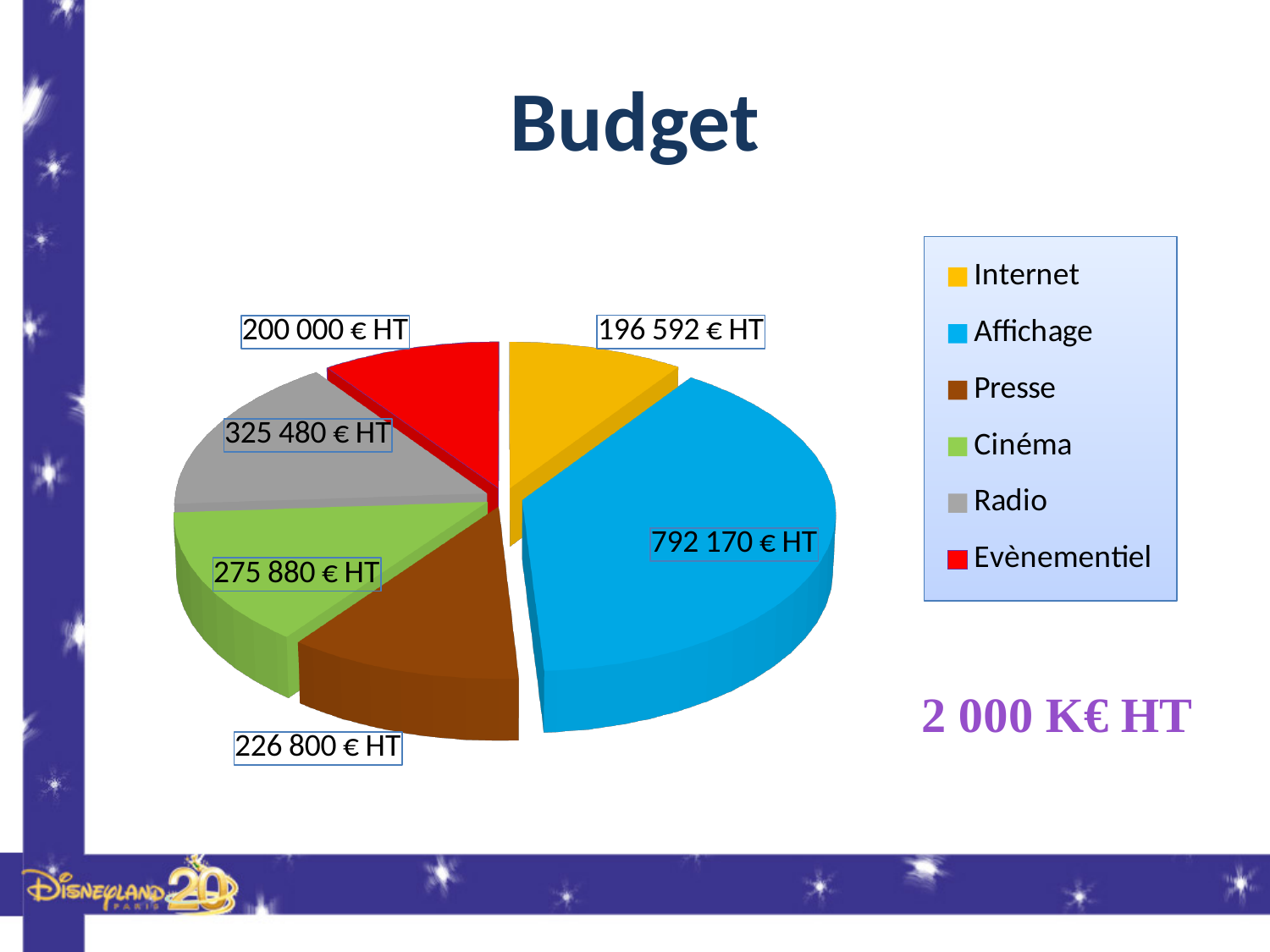
Which category has the largest slice of the Budget pie chart? Affichage What is the budget value for Radio? 325 480 € HT What is the budget value for Presse? 226 800 € HT What kind of chart is shown on the Budget slide? pie chart What colour represents Radio in the Budget pie chart? grey What is the budget value for Internet? 196 592 € HT How many categories does the legend of the Budget pie chart list? 6 What is the budget value for Cinéma? 275 880 € HT What is the budget value for Affichage? 792 170 € HT Which has a larger budget value, Evènementiel or Internet? Evènementiel Which category has the smallest value in the Budget pie chart? Internet What is the difference between the Affichage and Radio budget values? 466 690 € HT